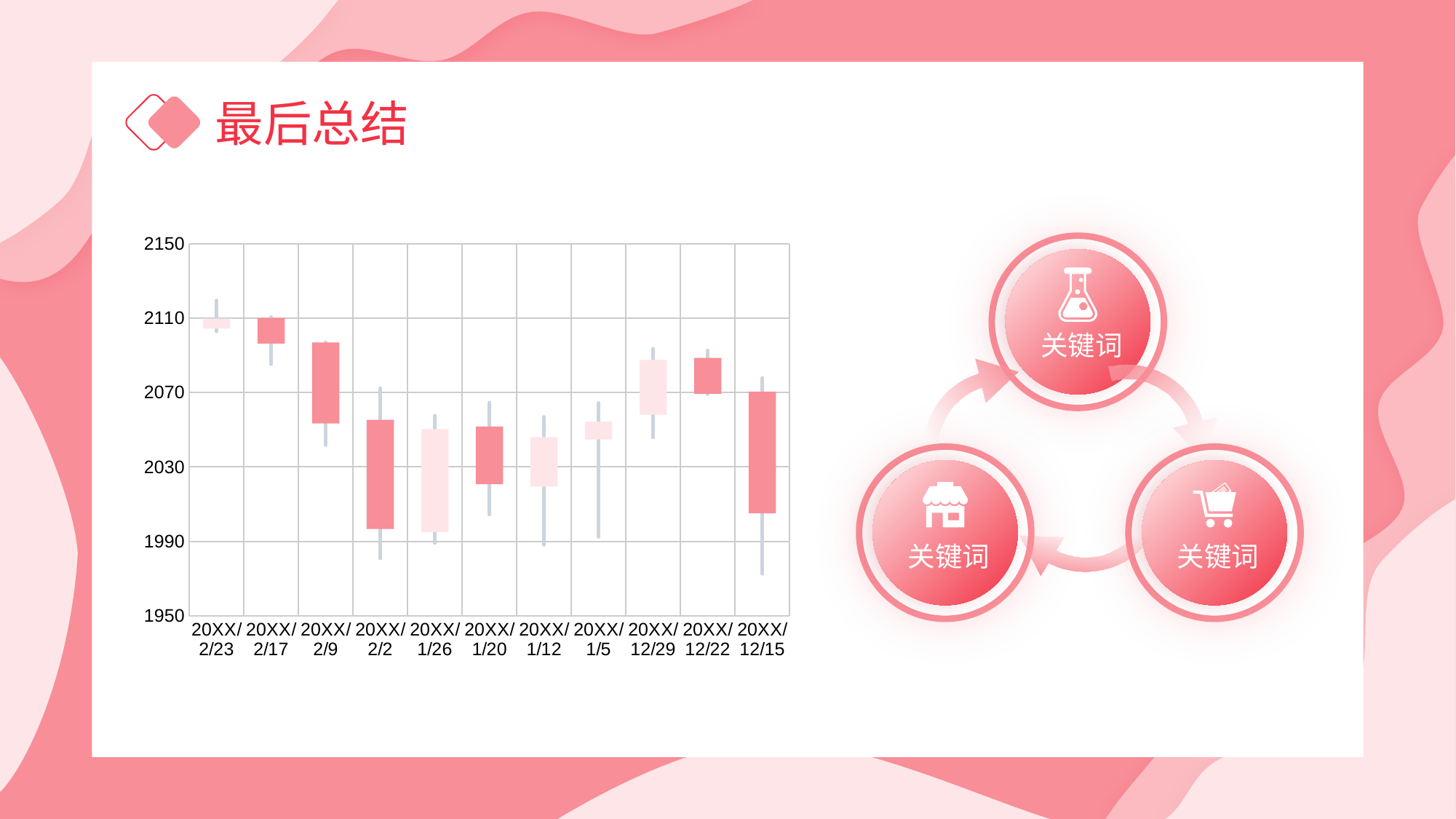
Is the lowest point of the candle for 20XX/12/22 greater or less than 2030? greater Is the highest point of the candle for 20XX/1/26 greater or less than 2070? less How many dates are plotted along the x axis of the chart? 11 Which date's candle reaches the lowest value on the chart? 20XX/12/15 What kind of chart is shown on the slide? candlestick chart Is the lowest point of the candle for 20XX/2/2 greater or less than 2030? less What is the lowest value shown on the chart's vertical axis? 1950 Which date's candle reaches the highest value on the chart? 20XX/2/23 What is the highest value shown on the chart's vertical axis? 2150